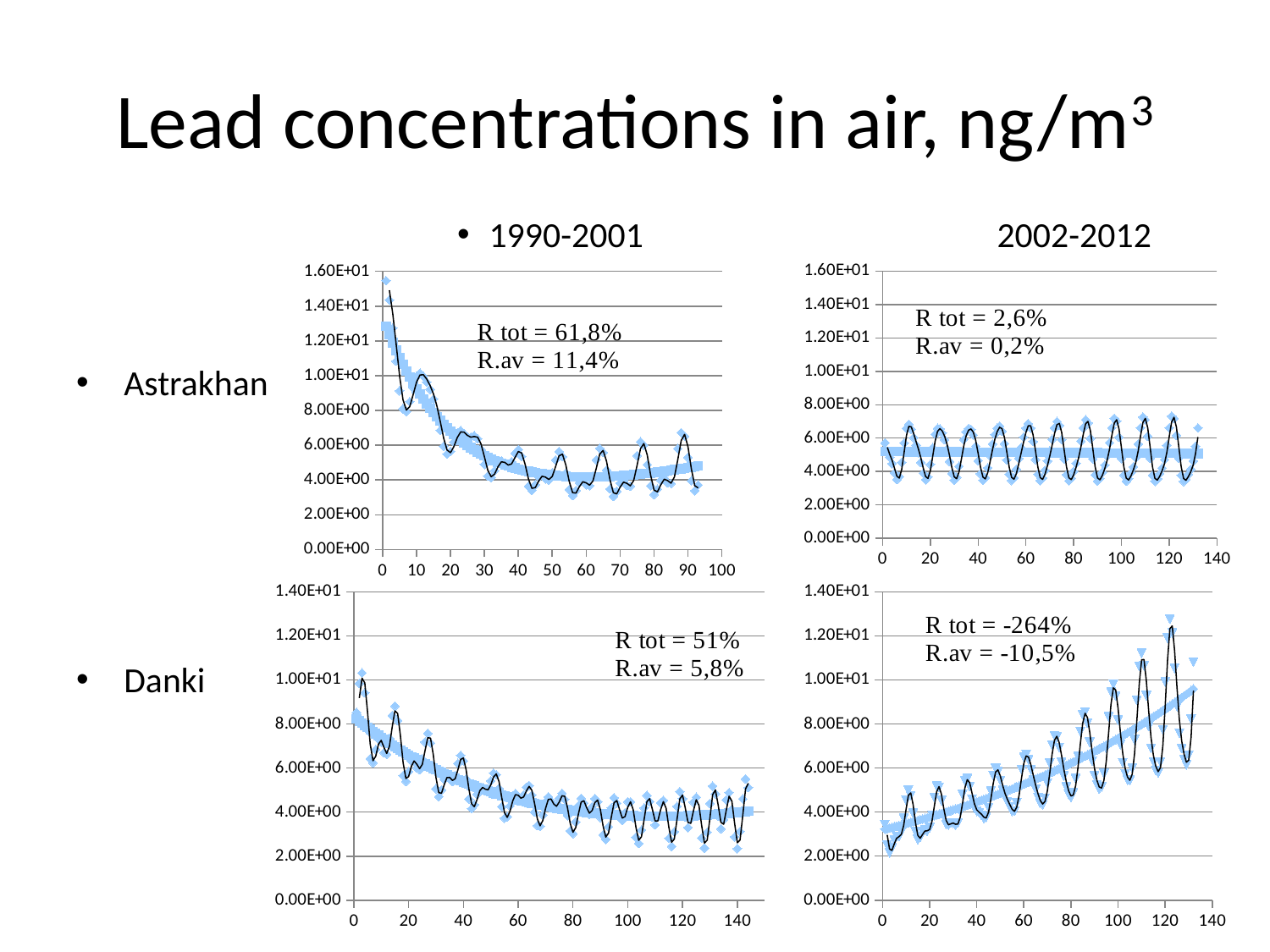
In the Danki 2002-2012 chart (bottom-right), do the values generally rise or fall along the x axis? rise In the Astrakhan 1990-2001 chart (top-left), do the values generally rise or fall along the x axis? fall What is the maximum value shown on the y axis of the Danki 1990-2001 chart (bottom-left)? 1.40E+01 In the Danki 2002-2012 chart (bottom-right), is the highest plotted value greater or less than 1.20E+01? greater What kind of chart is the Astrakhan 1990-2001 chart (top-left)? scatter chart with fitted line In the Danki 1990-2001 chart (bottom-left), do the values generally rise or fall along the x axis? fall What is the R.av value printed on the Danki 2002-2012 chart (bottom-right)? -10,5% In the Astrakhan 2002-2012 chart (top-right), is the highest plotted value greater or less than 8.00E+00? less How many charts are shown on the slide? 4 What is the R tot value printed on the Astrakhan 1990-2001 chart (top-left)? 61,8% In the Danki 1990-2001 chart (bottom-left), is the first plotted value (near x = 0) greater or less than 8.00E+00? greater